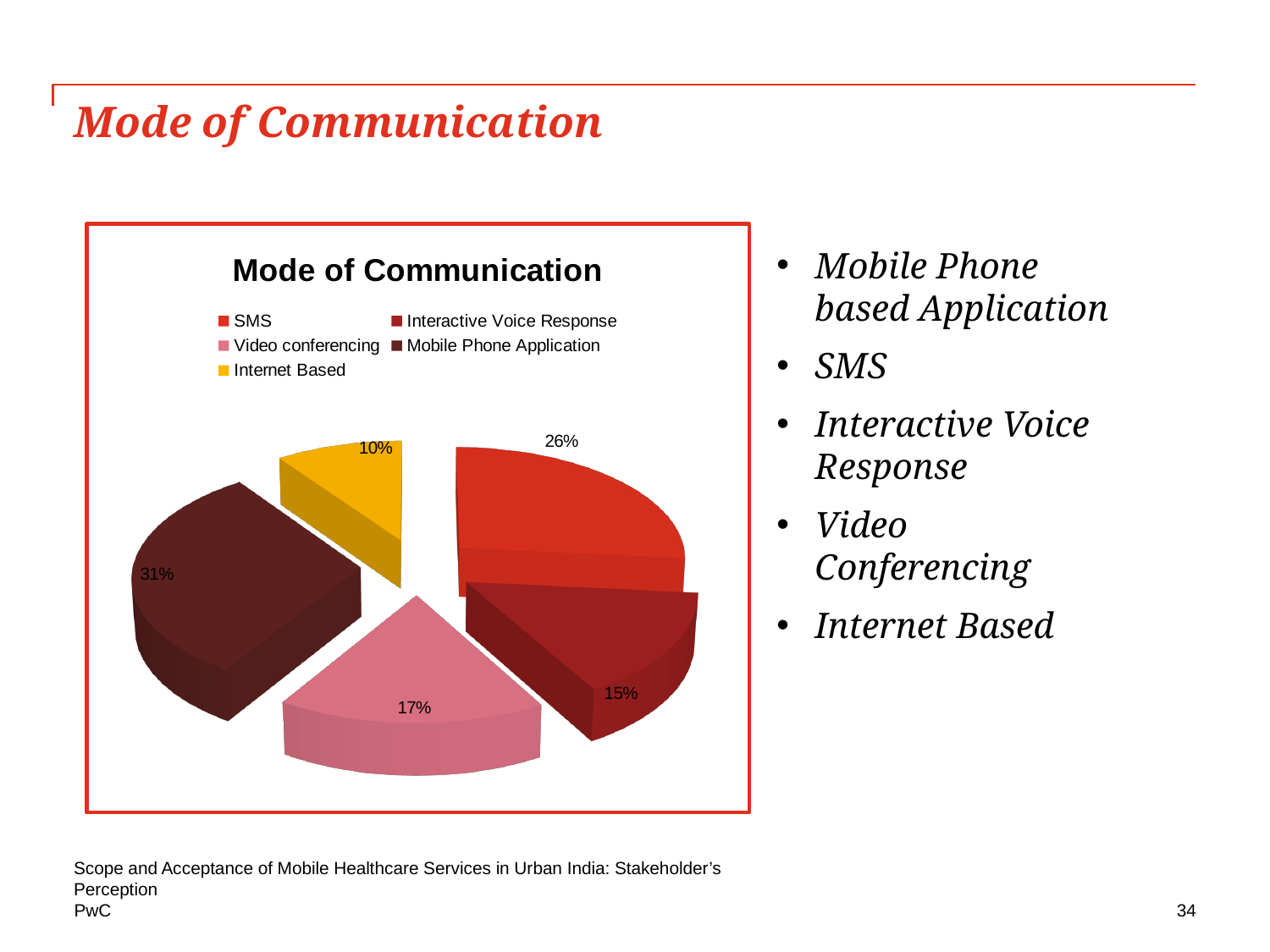
What percentage is shown for Interactive Voice Response? 15% What is the difference in percentage points between Mobile Phone Application and SMS? 5 Which has a larger share, Video conferencing or Interactive Voice Response? Video conferencing What share of the pie does SMS account for? 26% What percentage is shown for Mobile Phone Application? 31% What percentage is shown for Video conferencing? 17% What is the title of the chart? Mode of Communication Which mode of communication has the smallest share of the pie? Internet Based What type of chart is shown on the slide? Pie chart How many categories are shown in the pie chart? 5 Which mode of communication has the largest share of the pie? Mobile Phone Application What percentage is shown for Internet Based? 10%